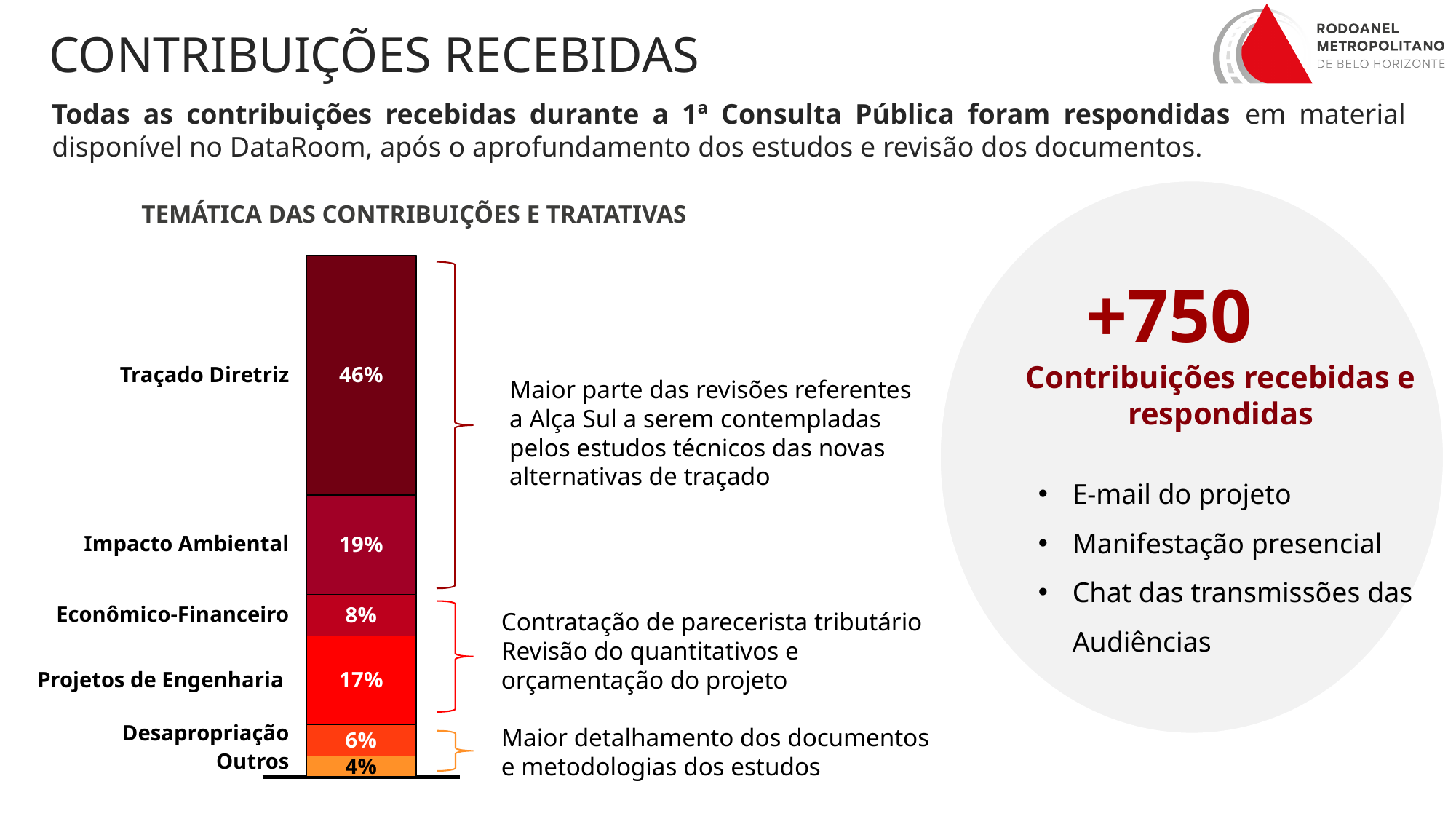
What is the difference in percentage points between Traçado Diretriz and Impacto Ambiental? 27 What is the title of the chart? TEMÁTICA DAS CONTRIBUIÇÕES E TRATATIVAS What percentage of contributions is attributed to Desapropriação? 6% What kind of chart is shown on the slide? Stacked bar chart Which category has the largest share of contributions? Traçado Diretriz What percentage of contributions is attributed to Projetos de Engenharia? 17% What percentage of contributions is attributed to Traçado Diretriz? 46% How many categories are shown in the stacked bar? 6 What percentage of contributions is attributed to Impacto Ambiental? 19% Which category has the smallest share of contributions? Outros What is the combined share of Desapropriação and Outros? 10% Which is larger, the share for Econômico-Financeiro or the share for Projetos de Engenharia? Projetos de Engenharia